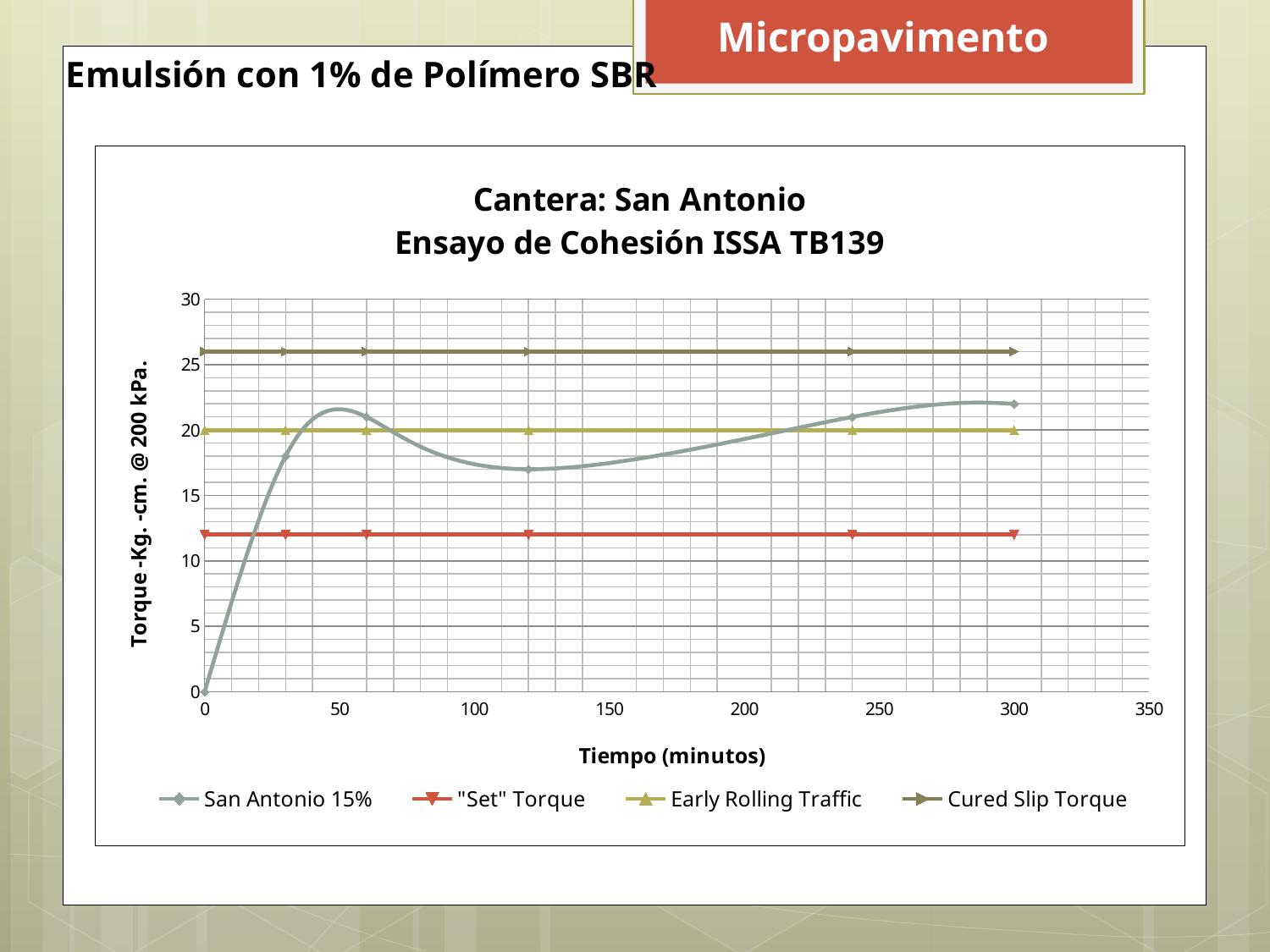
What is the value of the Early Rolling Traffic line? 20 Which is higher, the Cured Slip Torque line or the Early Rolling Traffic line? Cured Slip Torque What kind of chart is shown on the slide? line chart How many series does the legend list? 4 Is the value of San Antonio 15% at 120 minutes greater or less than 20? less What is the title of the x axis? Tiempo (minutos) Which series has the lowest value at 120 minutes? "Set" Torque Is the value of the "Set" Torque line greater or less than 15? less Is the value of the Cured Slip Torque line greater or less than 25? greater Which series has the highest values on the chart? Cured Slip Torque Does the San Antonio 15% series rise or fall between 0 and 30 minutes? rise What is the value of San Antonio 15% at 0 minutes? 0